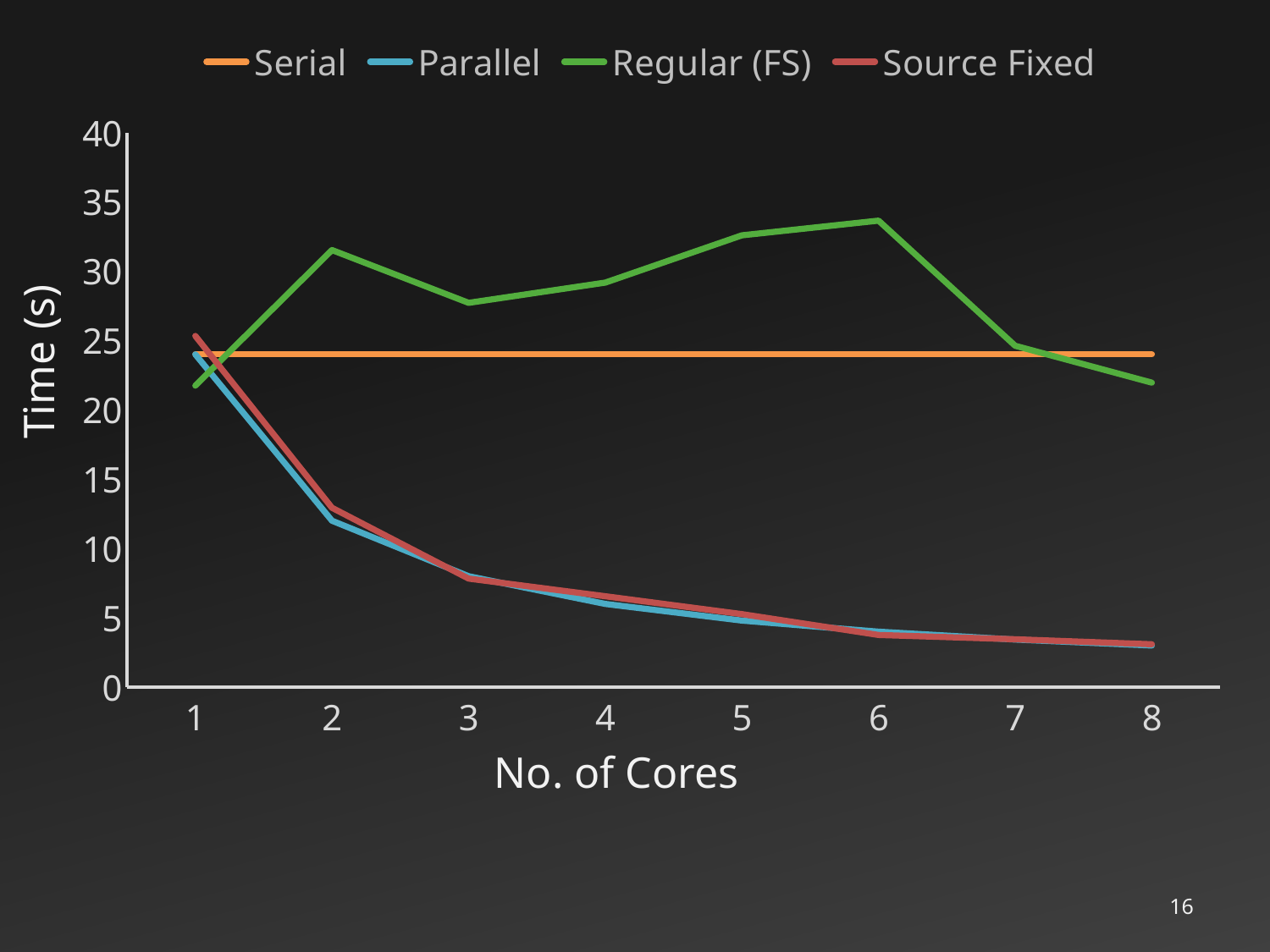
At which number of cores does the Parallel series reach its lowest value? 8 Is the Serial value at 4 cores greater or less than 20? greater How many core counts are plotted along the x axis? 8 How many series does the legend list? 4 At 2 cores, which series has the higher value: Regular (FS) or Parallel? Regular (FS) Is the Source Fixed value at 2 cores greater or less than 10? greater Is the Parallel value at 8 cores greater or less than 5? less Does the Parallel series rise or fall as the number of cores increases from 1 to 8? fall What is the label of the y axis? Time (s) What kind of chart is shown on the slide? line chart At which number of cores does the Regular (FS) series reach its highest value? 6